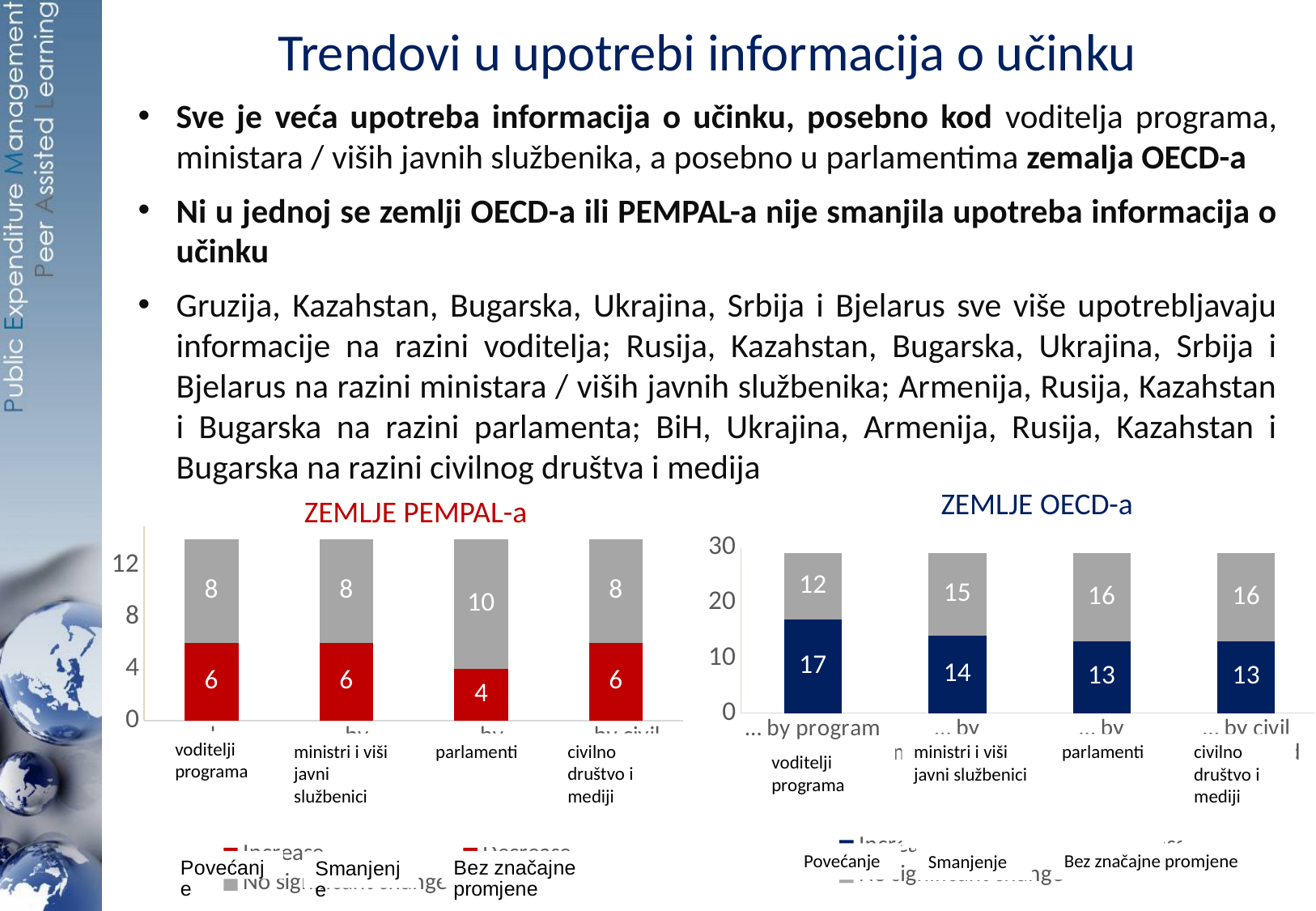
In the ZEMLJE PEMPAL-a chart, what is the total of the stacked bar for parlamenti? 14 What type of chart is the ZEMLJE OECD-a chart? stacked bar chart In the ZEMLJE PEMPAL-a chart, what is the value of the grey (Bez značajne promjene) segment for parlamenti? 10 In the ZEMLJE PEMPAL-a chart, which category has the lowest Povećanje (red) value? parlamenti In the ZEMLJE OECD-a chart, what is the value of the grey (Bez značajne promjene) segment for ministri i viši javni službenici? 15 In the ZEMLJE OECD-a chart, is the Povećanje value for voditelji programa larger or smaller than the Bez značajne promjene value for the same category? larger In the ZEMLJE OECD-a chart, which category has the highest Povećanje (dark blue) value? voditelji programa In the ZEMLJE OECD-a chart, what is the value of the dark blue (Povećanje) segment for voditelji programa? 17 In the ZEMLJE PEMPAL-a chart, what is the value of the red (Povećanje) segment for parlamenti? 4 In the ZEMLJE OECD-a chart, what is the total of the stacked bar for civilno društvo i mediji? 29 In the ZEMLJE OECD-a chart, what is the difference between the Povećanje values for voditelji programa and parlamenti? 4 How many categories are shown on the x axis of the ZEMLJE PEMPAL-a chart? 4